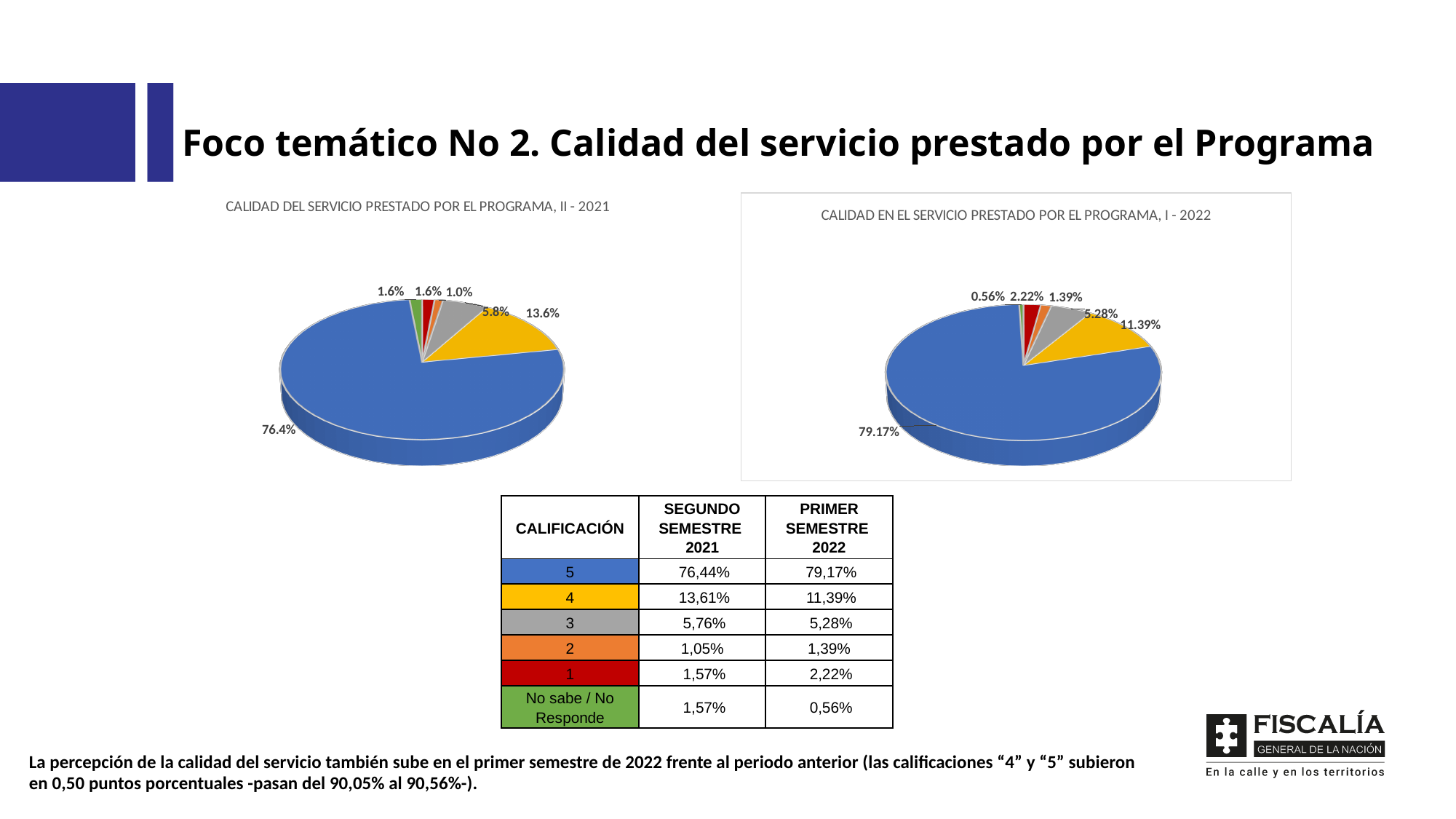
What is the title of the pie chart on the right side of the slide? CALIDAD EN EL SERVICIO PRESTADO POR EL PROGRAMA, I - 2022 In the 'CALIDAD DEL SERVICIO PRESTADO POR EL PROGRAMA, II - 2021' chart, what is the data label on the largest (blue) slice? 76.4% In the 'CALIDAD EN EL SERVICIO PRESTADO POR EL PROGRAMA, I - 2022' chart, what is the data label on the yellow slice? 11.39% What type of chart is used in the 'CALIDAD DEL SERVICIO PRESTADO POR EL PROGRAMA, II - 2021' chart? Pie chart In the 'CALIDAD EN EL SERVICIO PRESTADO POR EL PROGRAMA, I - 2022' chart, what is the data label on the grey slice? 5.28% How many slices does the 'CALIDAD DEL SERVICIO PRESTADO POR EL PROGRAMA, II - 2021' pie chart have? 6 Which chart has the larger blue slice: the II - 2021 chart or the I - 2022 chart? I - 2022 What is the difference between the yellow slice in the II - 2021 chart (13.6%) and the yellow slice in the I - 2022 chart (11.39%)? 2.21% In the 'CALIDAD EN EL SERVICIO PRESTADO POR EL PROGRAMA, I - 2022' chart, what is the data label on the largest (blue) slice? 79.17% In the 'CALIDAD DEL SERVICIO PRESTADO POR EL PROGRAMA, II - 2021' chart, what is the data label on the yellow slice? 13.6% In the 'CALIDAD EN EL SERVICIO PRESTADO POR EL PROGRAMA, I - 2022' chart, which slice has the smallest share? The green slice (0.56%) How many slices does the 'CALIDAD EN EL SERVICIO PRESTADO POR EL PROGRAMA, I - 2022' pie chart have? 6